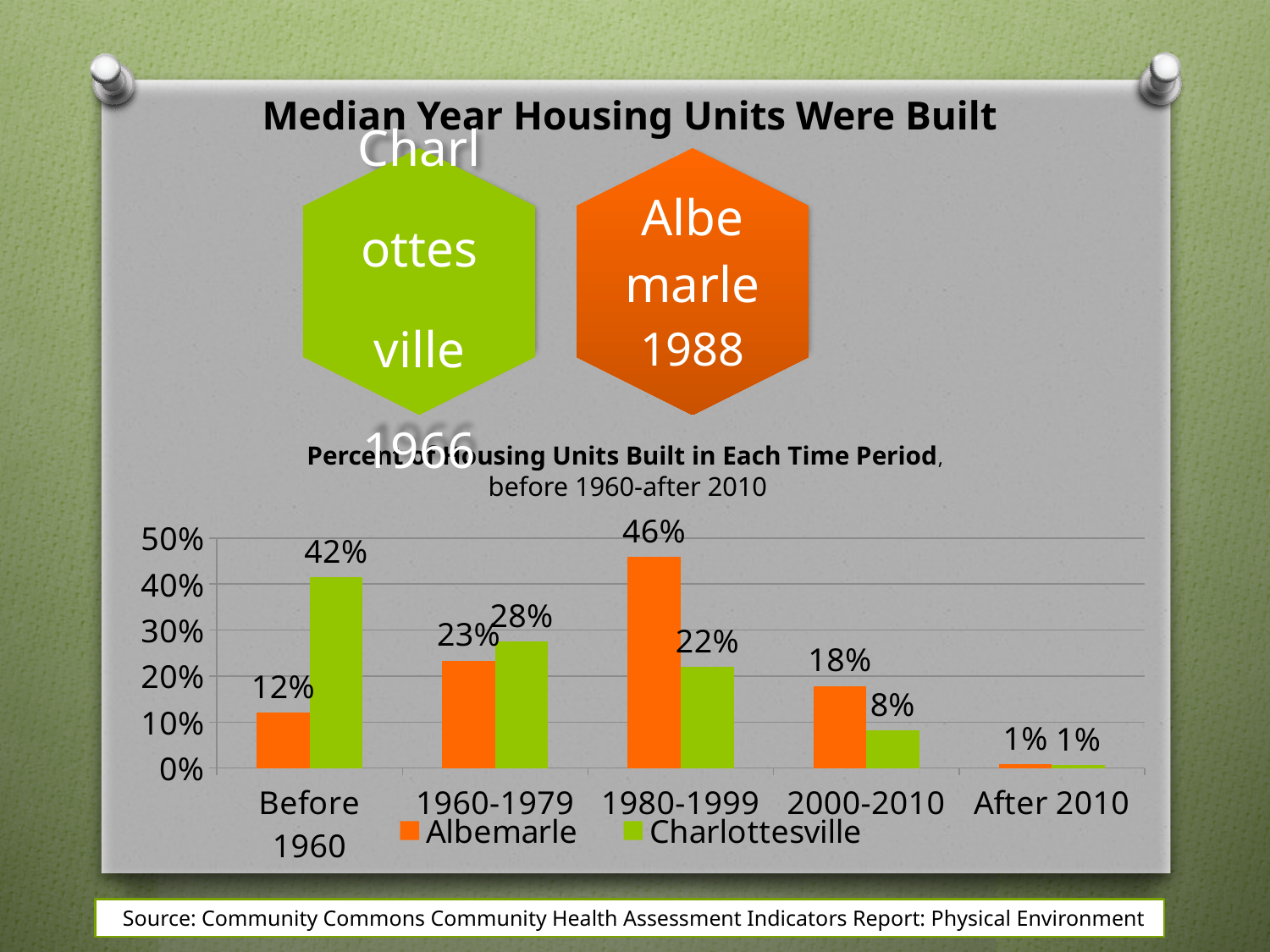
How many series does the legend of the bar chart list? 2 Which is larger for 1980-1999, Albemarle or Charlottesville? Albemarle What percent of Charlottesville housing units were built before 1960? 42% In which time period is the Albemarle value highest? 1980-1999 Which colour represents Charlottesville in the bar chart? green What kind of chart shows the percent of housing units built in each time period? bar chart How many time periods are shown on the x axis of the bar chart? 5 What is the Albemarle value for 1960-1979? 23% What percent of Albemarle housing units were built in 1980-1999? 46% What is the difference between the Charlottesville and Albemarle values for Before 1960? 30% In which time period is the Charlottesville value lowest? After 2010 What is the Charlottesville value for 2000-2010? 8%